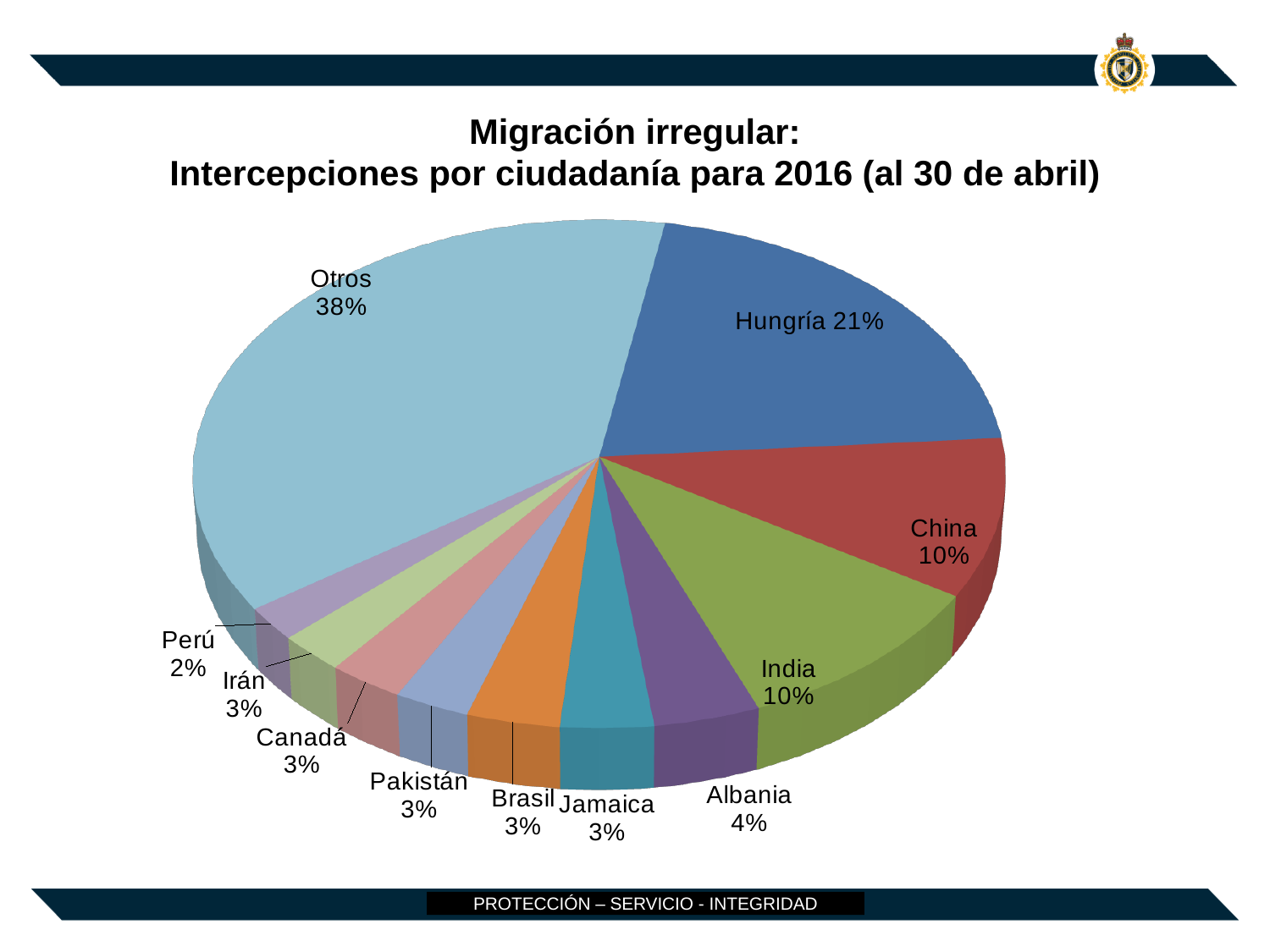
What is the difference in percentage points between Hungría and India? 11 What percentage is shown for China? 10% What is the title of the chart? Migración irregular: Intercepciones por ciudadanía para 2016 (al 30 de abril) Which category has the largest slice of the pie? Otros What percentage is shown for Albania? 4% What kind of chart is shown on the slide? pie chart What is the difference in percentage points between Otros and Hungría? 17 How many slices does the pie chart have? 11 What share of interceptions does Hungría account for? 21% What percentage is shown for Perú? 2% Which is larger, the share for Albania or the share for Jamaica? Albania Which category has the smallest slice of the pie? Perú